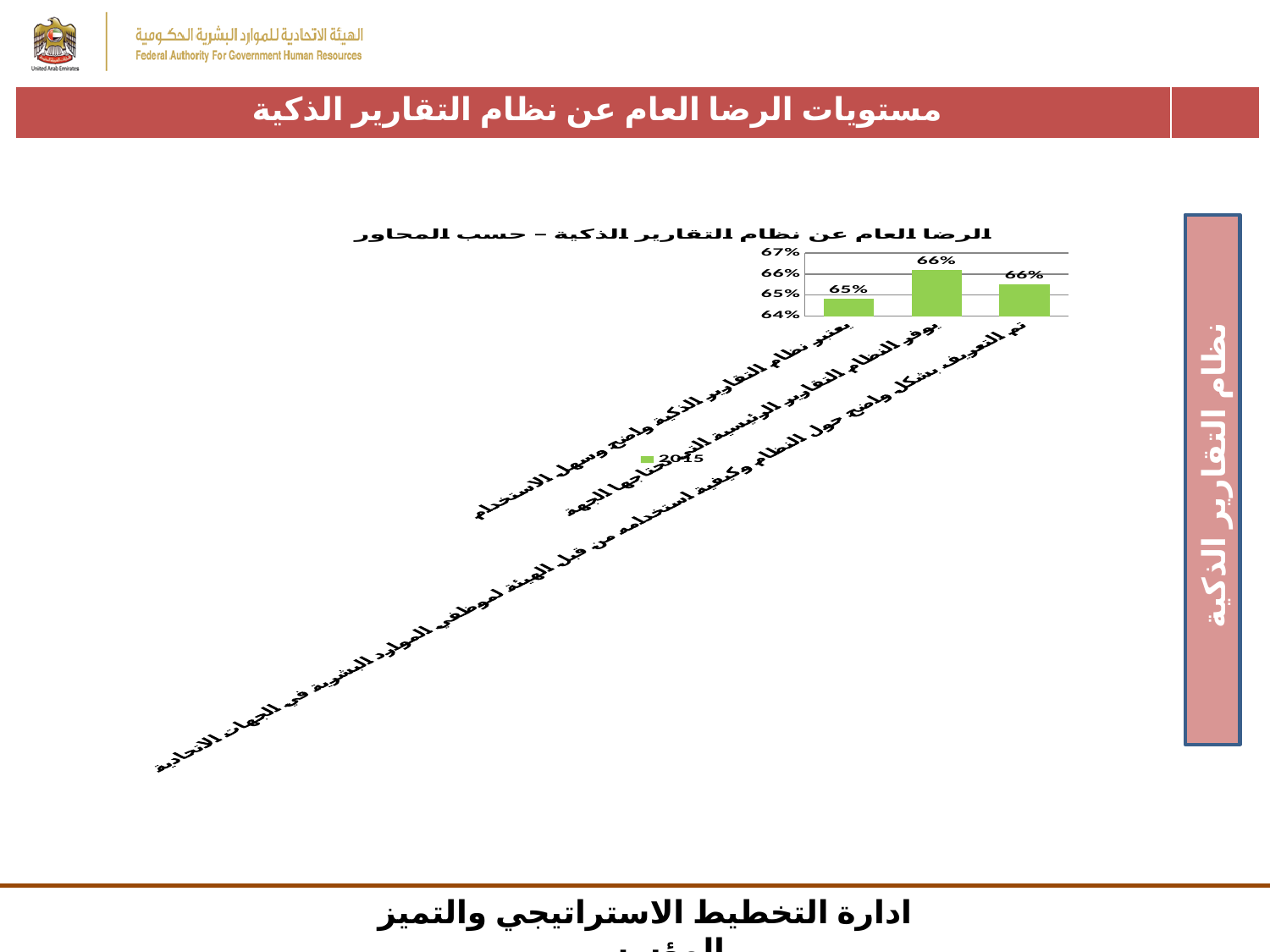
What is the difference between the middle bar and the leftmost bar? 1% What year does the chart legend show? 2015 How many bars (categories) does the chart show? 3 What is the value of the leftmost bar in the chart? 65% What is the value of the middle bar in the chart? 66% Which category has the lowest value in the chart? يعتبر نظام التقارير الذكية واضح وسهل الاستخدام What kind of chart is shown on the slide? bar chart What is the title of the chart? الرضا العام عن نظام التقارير الذكية – حسب المحاور What is the value for the category 'يعتبر نظام التقارير الذكية واضح وسهل الاستخدام'? 65% Which is larger, the value of the middle bar or the value of the leftmost bar? the middle bar What is the value of the rightmost bar in the chart? 66% How many series does the chart legend list? 1